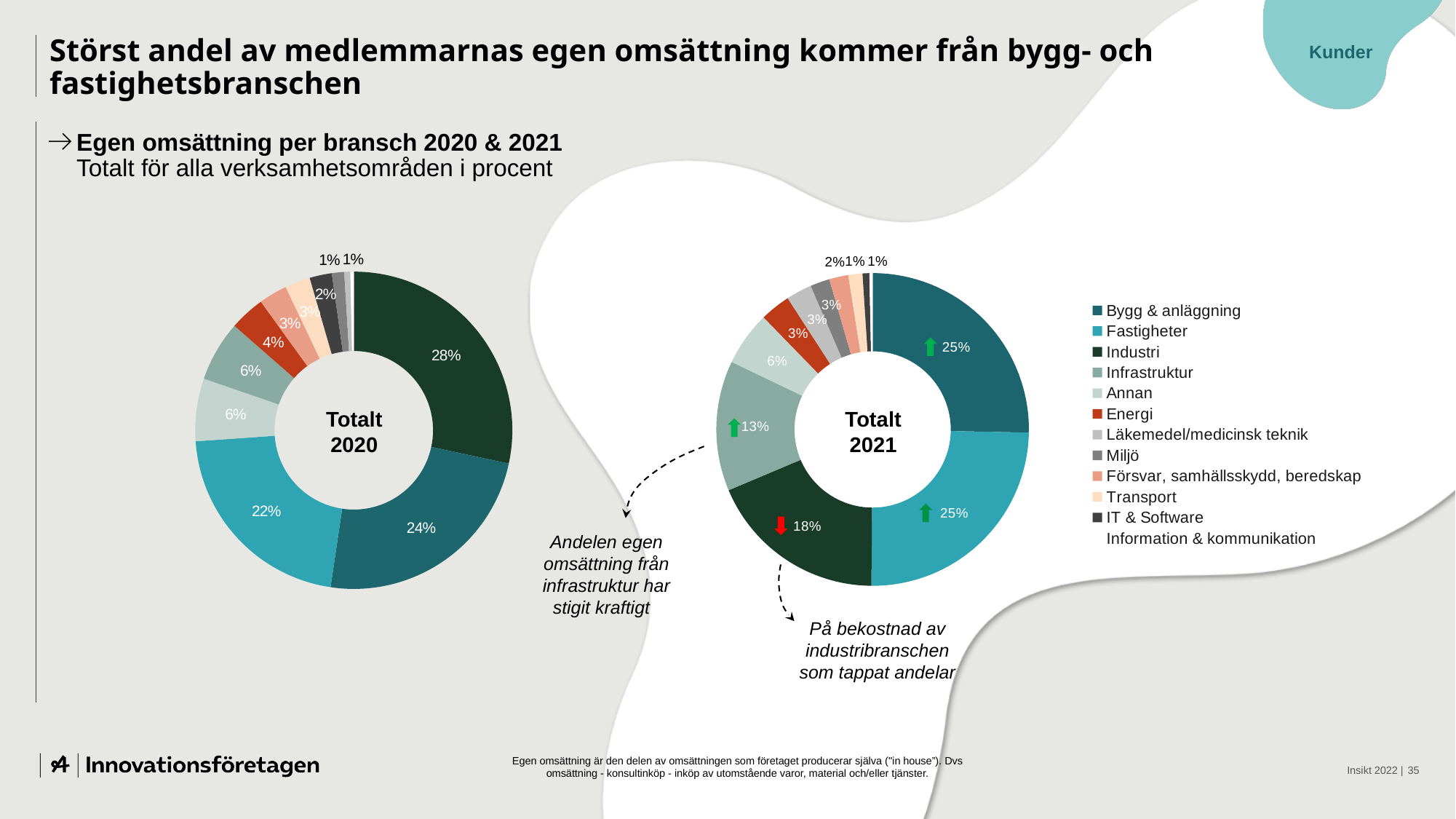
By how many percentage points did the Infrastruktur share rise from the Totalt 2020 chart (6%) to the Totalt 2021 chart (13%)? 7 percentage points In the Totalt 2021 chart, what share does Bygg & anläggning have? 25% How many categories does the legend list? 12 In the Totalt 2020 chart, which category has the largest share? Industri What text is shown in the centre of the left donut chart? Totalt 2020 In the Totalt 2021 chart, which is larger: the share for Industri or the share for Infrastruktur? Industri By how many percentage points did the Industri share fall from the Totalt 2020 chart to the Totalt 2021 chart? 10 percentage points In the Totalt 2021 chart, what share does Infrastruktur have? 13% In the Totalt 2021 chart, what share does Industri have? 18% In the Totalt 2021 chart, what share does Annan have? 6% What kind of chart is used for the Totalt 2020 and Totalt 2021 figures? Donut (pie) chart In the Totalt 2020 chart, what share does Industri have? 28%